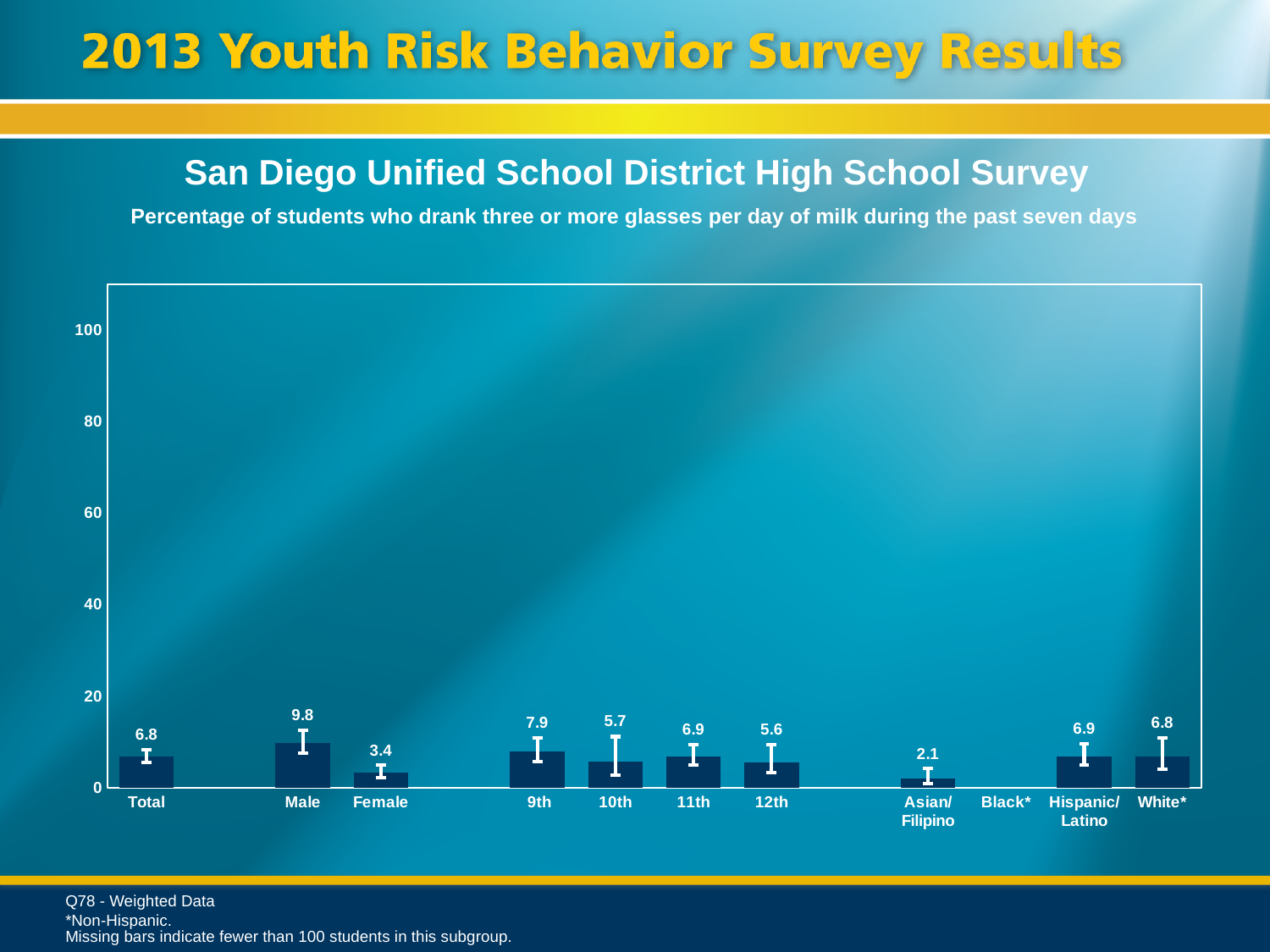
How many categories are labeled on the x axis? 11 What is the difference between the Male and Female values? 6.4 What is the value for 9th grade? 7.9 What kind of chart is shown? bar chart Which category with a plotted bar has the lowest value? Asian/Filipino What is the value for Male? 9.8 What is the value for Asian/Filipino? 2.1 Which is larger, the value for 10th grade or the value for 11th grade? 11th Which category has the highest value? Male Is the value for Total greater or less than 20? less What is the value for Female? 3.4 Which category has no bar plotted? Black*